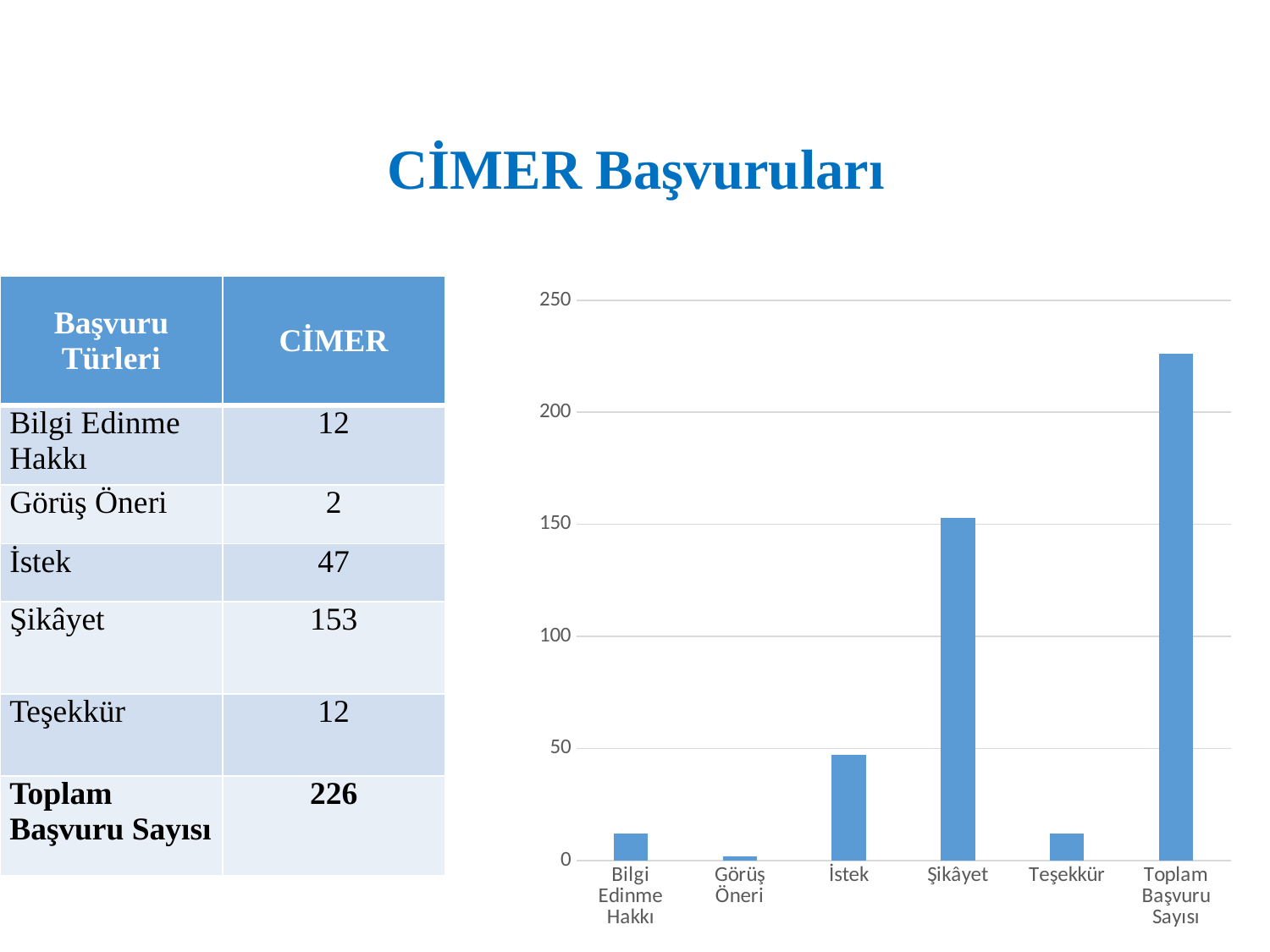
What is the difference between the values for Şikâyet and İstek? 106 What type of chart is shown on the slide? bar chart Which category has the lowest bar in the chart? Görüş Öneri What is the value for Toplam Başvuru Sayısı? 226 What is the value for Şikâyet? 153 Which category has the highest bar in the chart? Toplam Başvuru Sayısı Is the value for İstek greater or less than 50? less How many categories are shown on the x axis of the chart? 6 Which is larger, the value for İstek or the value for Teşekkür? İstek Is the value for Şikâyet greater or less than 100? greater What is the title of the slide containing the chart? CİMER Başvuruları What is the value for İstek? 47